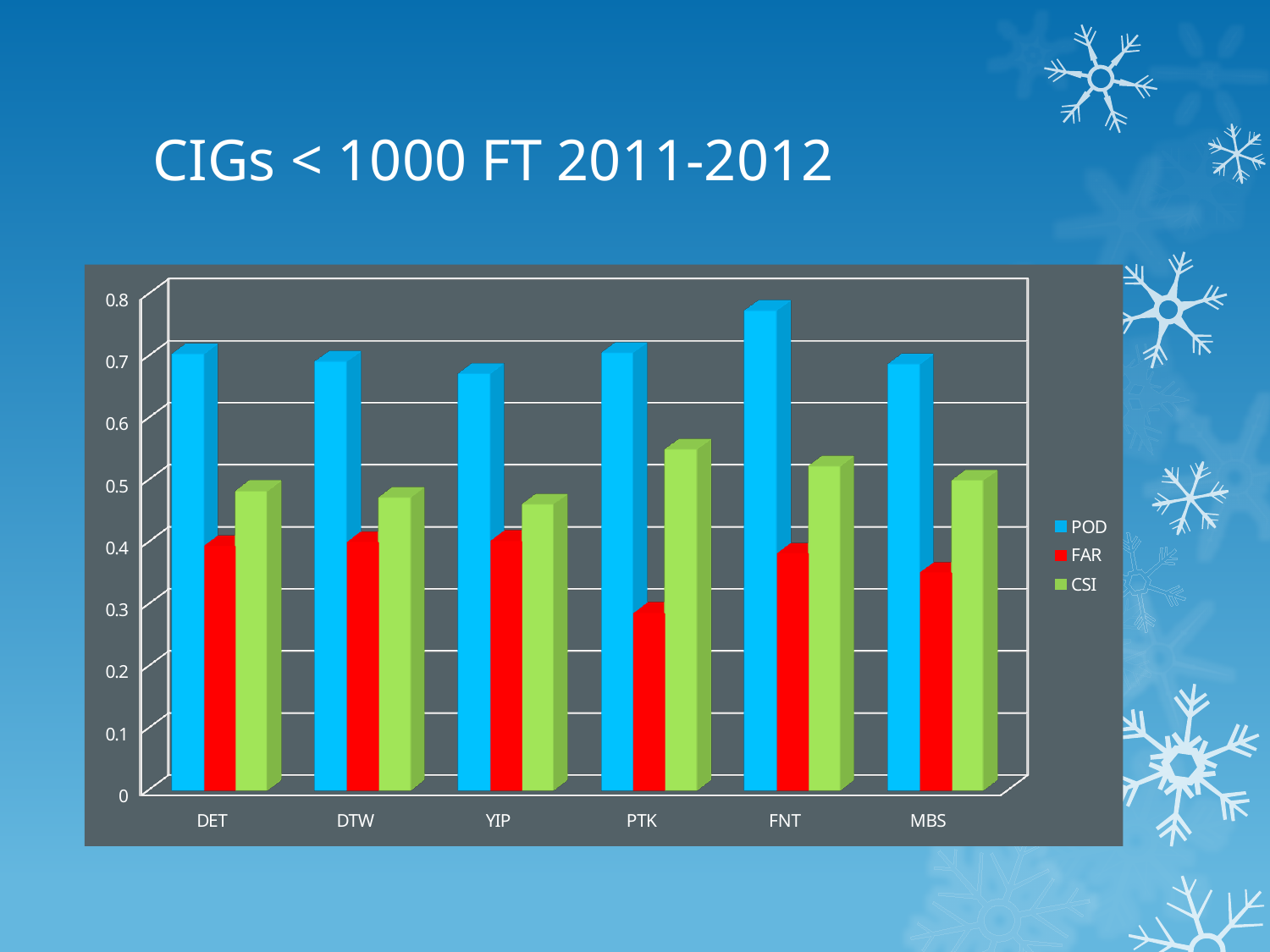
How many categories (airports) are shown on the x axis? 6 What is the title of the slide? CIGs < 1000 FT 2011-2012 Which series has the tallest bars in every category? POD For PTK, which is larger, the FAR value or the CSI value? CSI How many series does the legend list? 3 Which category has the lowest FAR value? PTK Is the POD value for FNT greater or less than 0.7? greater What kind of chart is shown on the slide? bar chart Which category has the highest CSI value? PTK Which category has the highest POD value? FNT